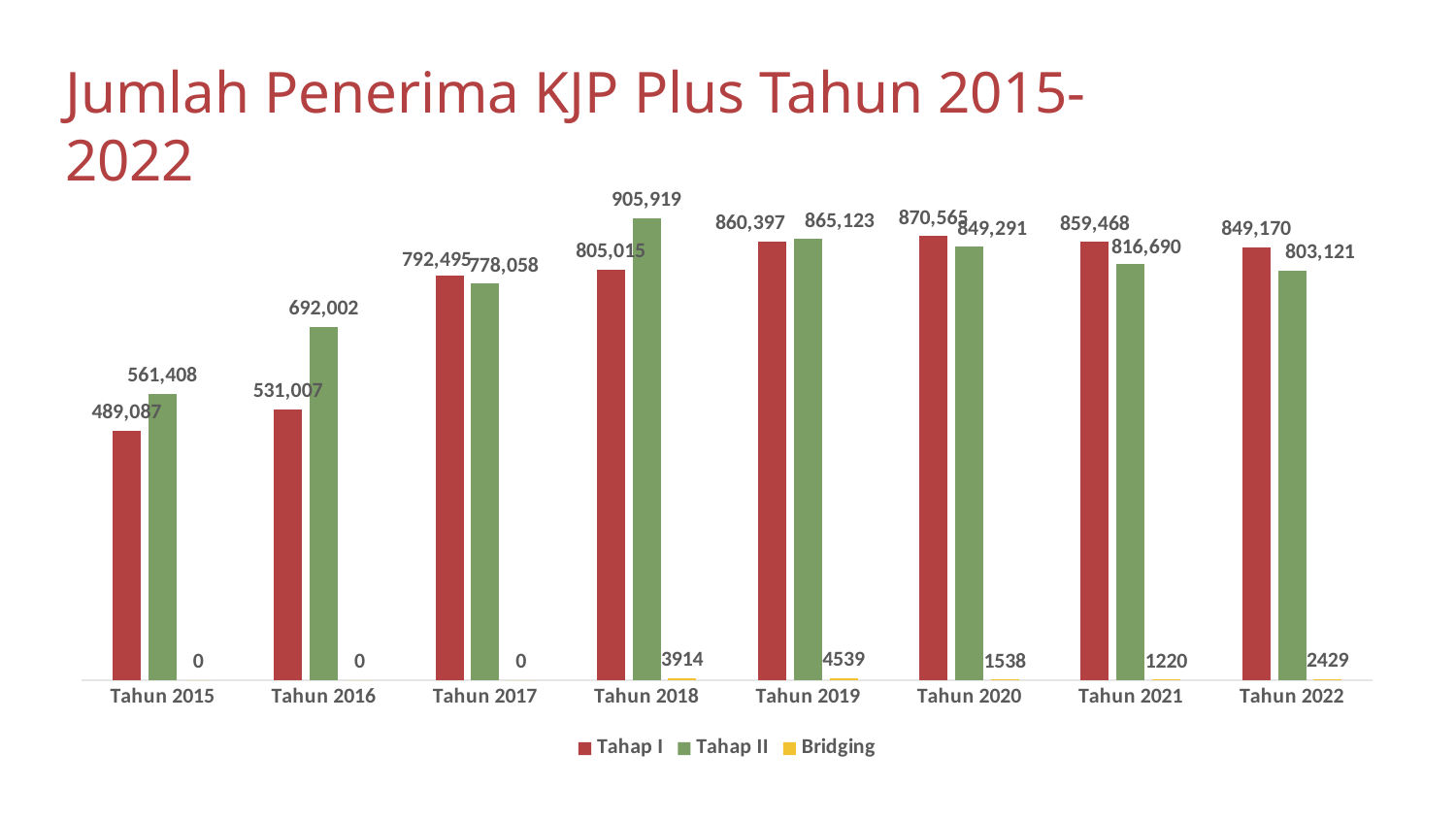
What is the title of the chart? Jumlah Penerima KJP Plus Tahun 2015-2022 Which year has the highest Tahap I value? Tahun 2020 What is the value of Tahap II for Tahun 2018? 905,919 What is the difference between Tahap II and Tahap I for Tahun 2016? 160,995 Does the Tahap I value rise or fall from Tahun 2015 to Tahun 2018? Rise How many series does the legend list? 3 What is the Bridging value for Tahun 2019? 4539 For Tahun 2017, which is larger: Tahap I or Tahap II? Tahap I Which year has the lowest Tahap II value? Tahun 2015 How many years are shown on the x axis? 8 What is the value of Tahap I for Tahun 2015? 489,087 What kind of chart is shown on the slide? Bar chart